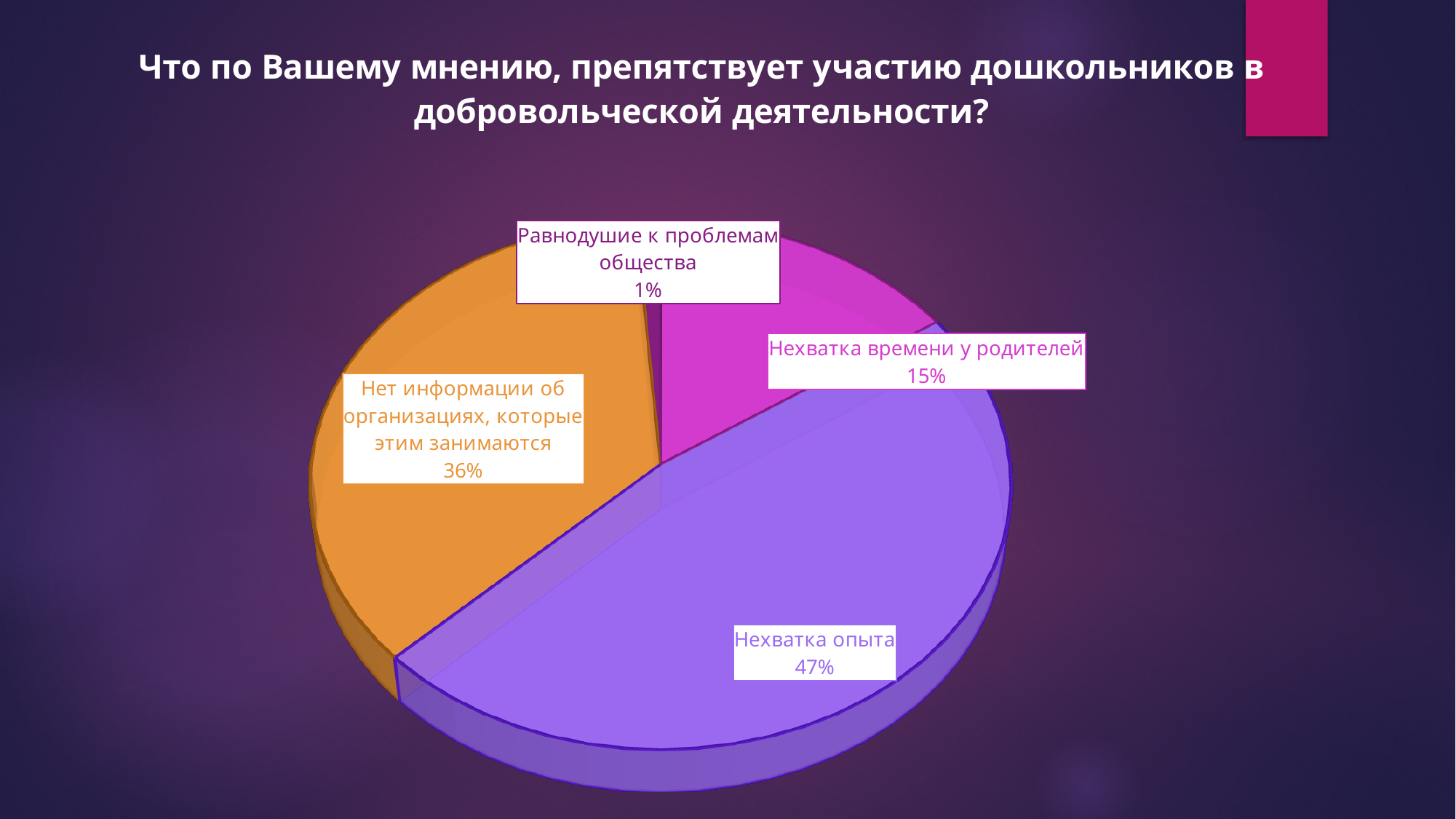
Which category has the largest slice of the pie? Нехватка опыта What is the difference between the shares for "Нехватка опыта" and "Нет информации об организациях, которые этим занимаются"? 11% What is the difference between the shares for "Нехватка времени у родителей" and "Равнодушие к проблемам общества"? 14% What share of the pie is labelled "Нет информации об организациях, которые этим занимаются"? 36% Which category has the smallest slice of the pie? Равнодушие к проблемам общества What share of the pie is labelled "Нехватка опыта"? 47% What share of the pie is labelled "Равнодушие к проблемам общества"? 1% What kind of chart is shown on the slide? pie chart What colour is the slice for "Нехватка опыта"? purple How many categories are shown in the pie chart? 4 Which is larger: the share for "Нет информации об организациях, которые этим занимаются" or the share for "Нехватка времени у родителей"? Нет информации об организациях, которые этим занимаются